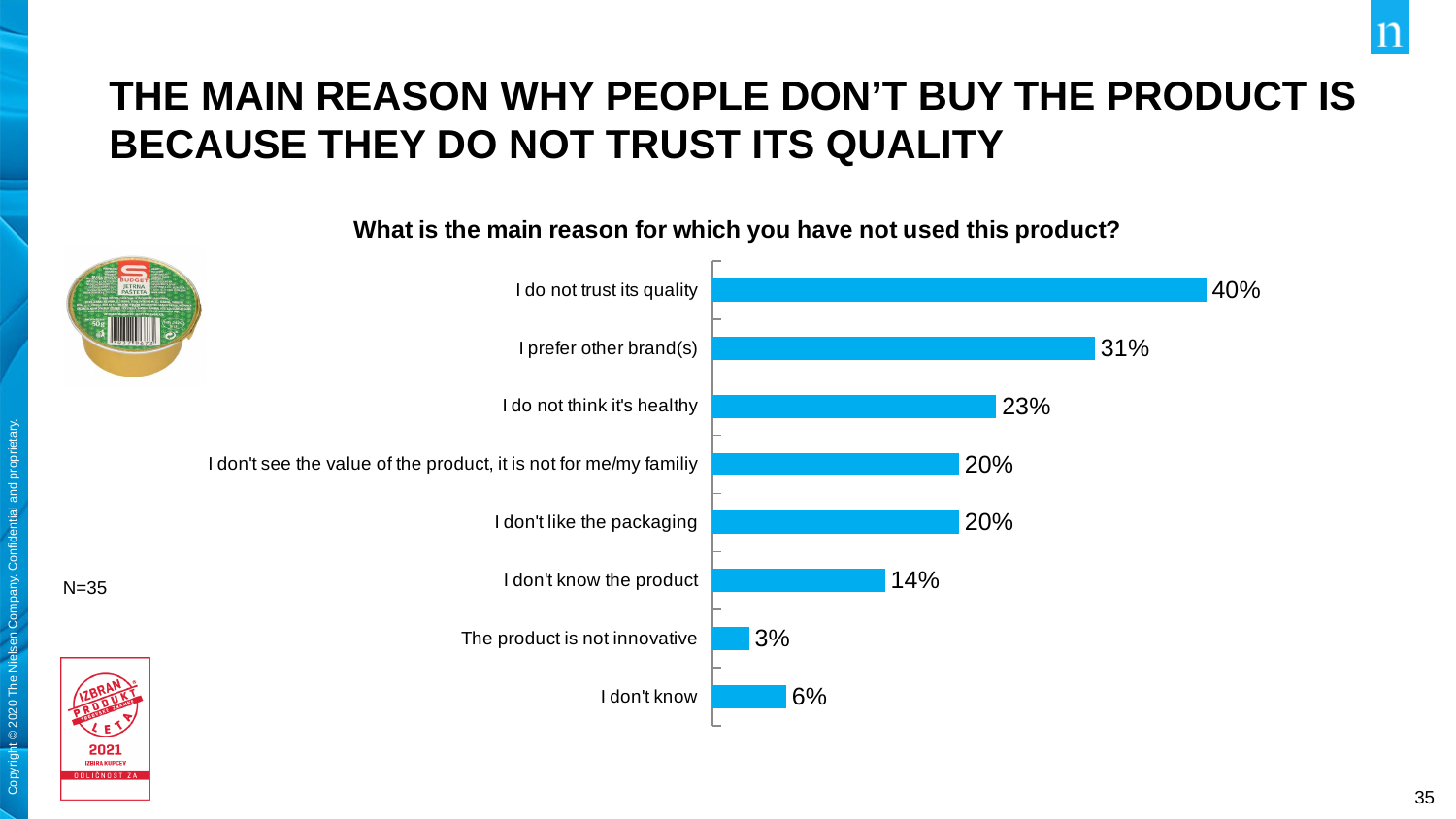
What question is the chart based on? What is the main reason for which you have not used this product? Which is larger: "I don't know" or "The product is not innovative"? I don't know What is the value for "I prefer other brand(s)"? 31% What kind of chart is shown on the slide? Bar chart What is the difference between "I do not think it's healthy" and "I don't like the packaging"? 3% What percentage of respondents said "I do not trust its quality"? 40% What percentage chose "I don't know the product"? 14% What is the difference between "I do not trust its quality" and "I prefer other brand(s)"? 9% What is the sample size (N) shown on the slide? N=35 How many reasons are shown in the chart? 8 Which reason has the highest percentage? I do not trust its quality Which reason has the lowest percentage? The product is not innovative